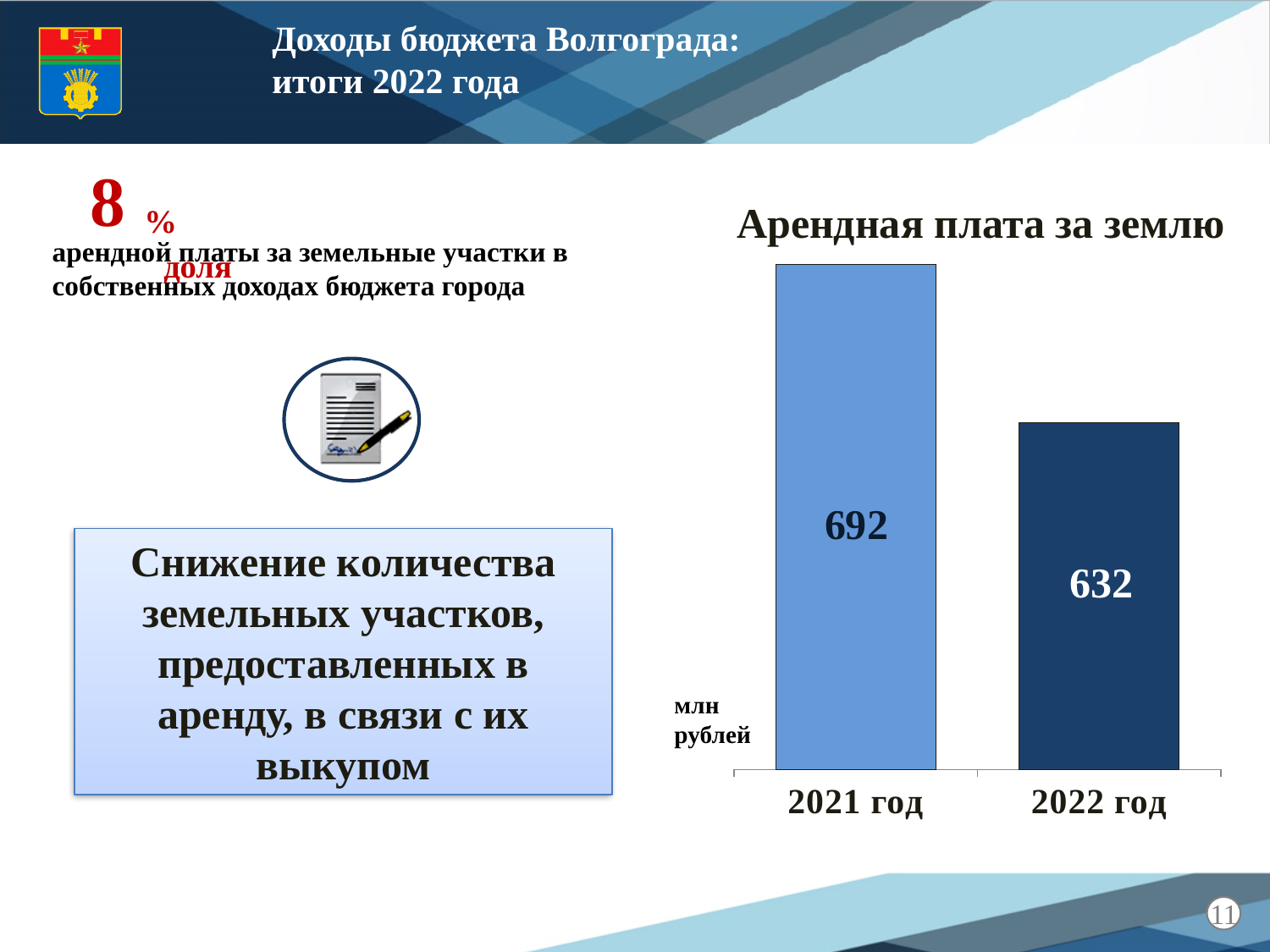
What is the difference between the values for 2021 год and 2022 год? 60 What unit is indicated for the values in the chart? млн рублей What is the title of the chart? Арендная плата за землю Which year has the highest value in the chart? 2021 год What kind of chart is shown on the slide? bar chart How many categories are shown in the chart? 2 What is the value for 2022 год in the chart? 632 Which year has the lowest value in the chart? 2022 год Do the values rise or fall from 2021 год to 2022 год? fall What is the value for 2021 год in the chart? 692 Which is larger, the value for 2021 год or for 2022 год? 2021 год